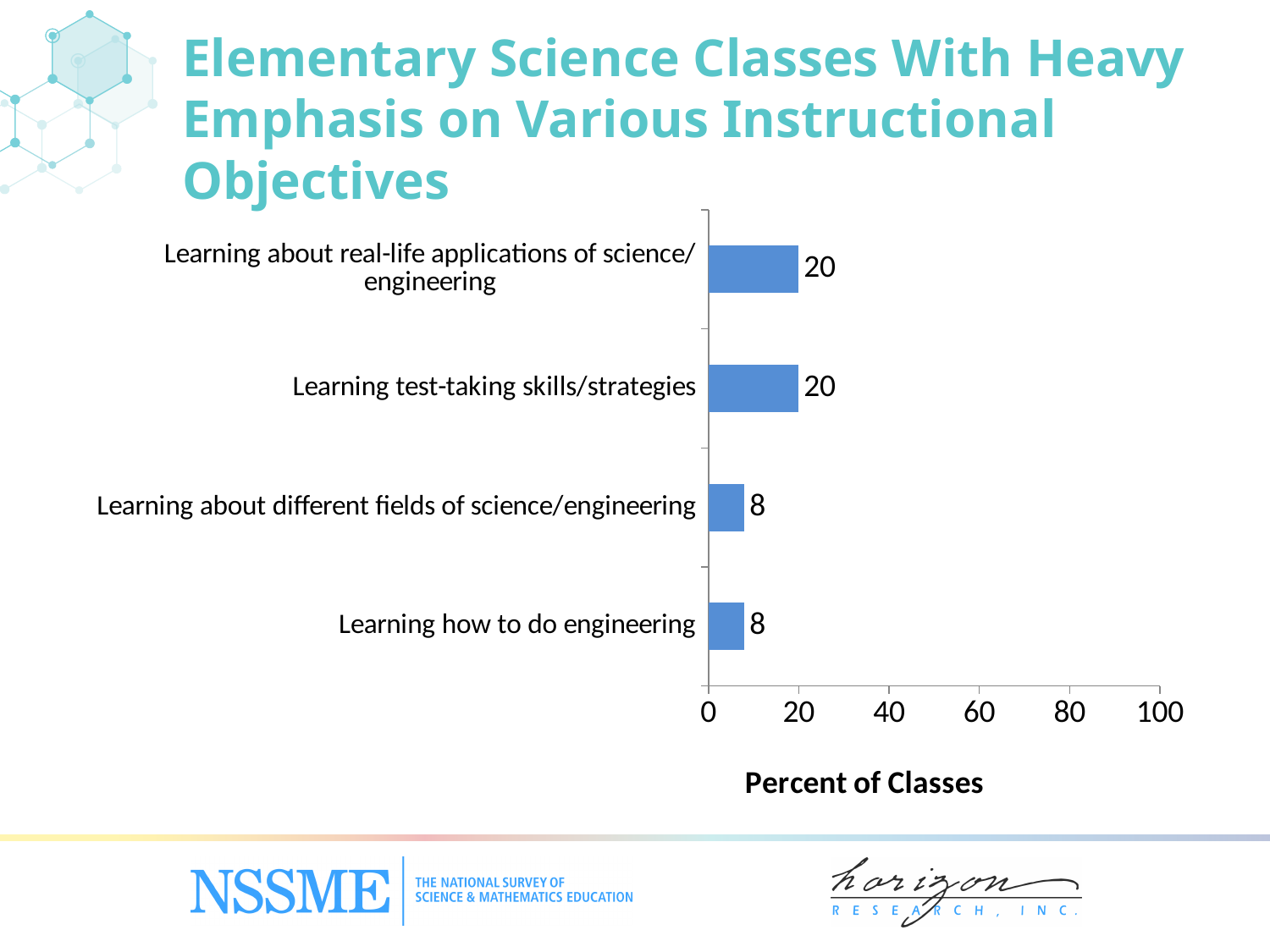
What is the label of the horizontal axis? Percent of Classes What percent of classes place heavy emphasis on learning test-taking skills/strategies? 20 What is the value for learning about real-life applications of science/engineering? 20 Is the value for learning test-taking skills/strategies greater or less than 40? less Which is larger: the value for learning about real-life applications of science/engineering or the value for learning about different fields of science/engineering? Learning about real-life applications of science/engineering What is the value for learning about different fields of science/engineering? 8 What is the maximum value shown on the horizontal axis? 100 What kind of chart is shown on the slide? Bar chart What is the difference between the value for learning test-taking skills/strategies and the value for learning how to do engineering? 12 What is the value for learning how to do engineering? 8 Is the value for learning how to do engineering greater or less than 20? less How many instructional objectives are shown in the chart? 4